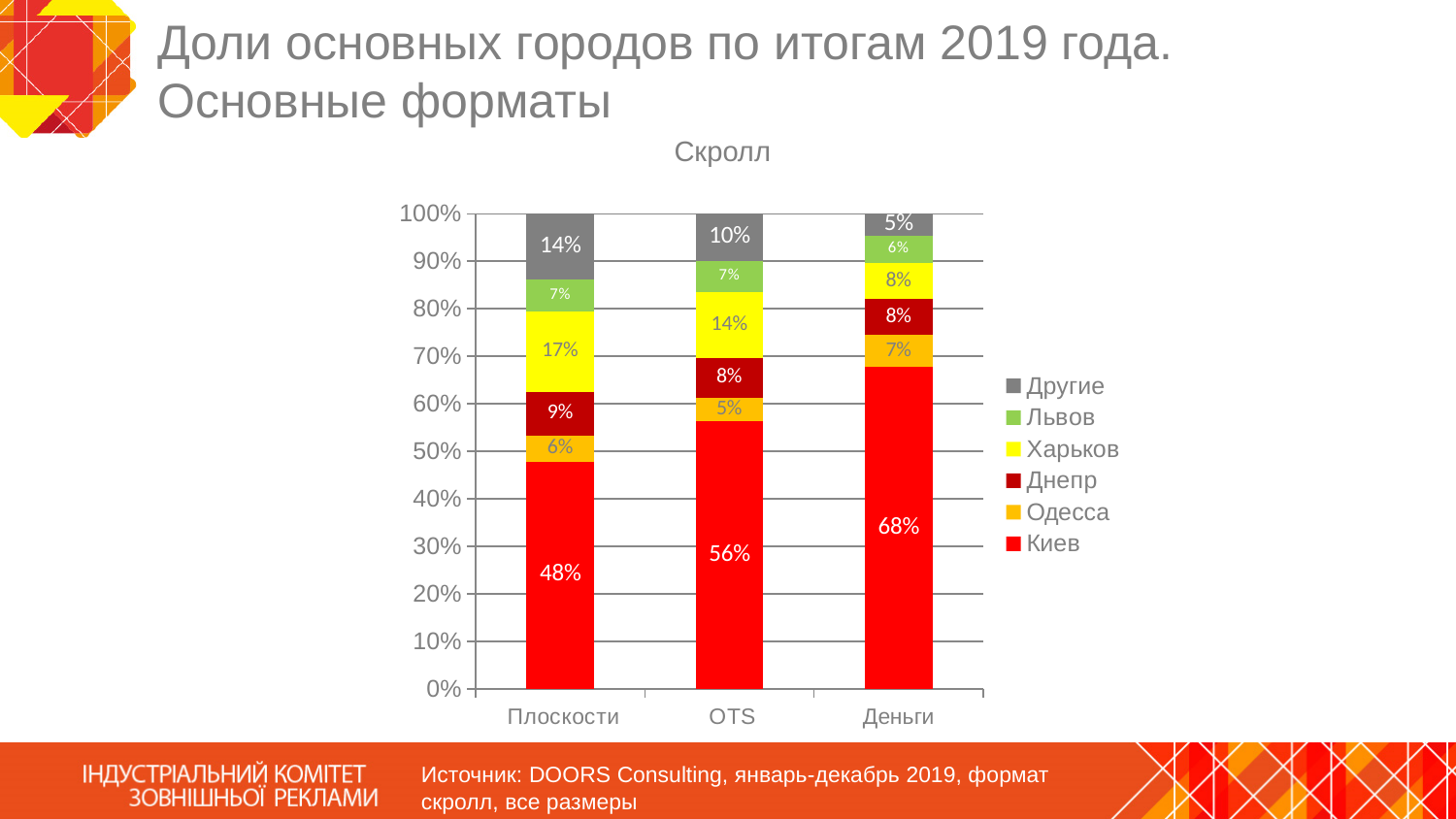
In which category does Другие have the lowest share? Деньги How many series does the legend list? 6 Which is larger: the Харьков share in OTS or the Харьков share in Деньги? OTS What is the difference between the Киев share in Деньги and in Плоскости? 20% What is the share of Другие in the OTS bar? 10% What is the share of Харьков in the Плоскости bar? 17% How many categories are shown on the x axis? 3 What kind of chart is shown? Stacked bar chart What is the share of Киев in the Деньги bar? 68% What is the title of the chart? Скролл What is the share of Одесса in the OTS bar? 5% In which category does Киев have the highest share? Деньги